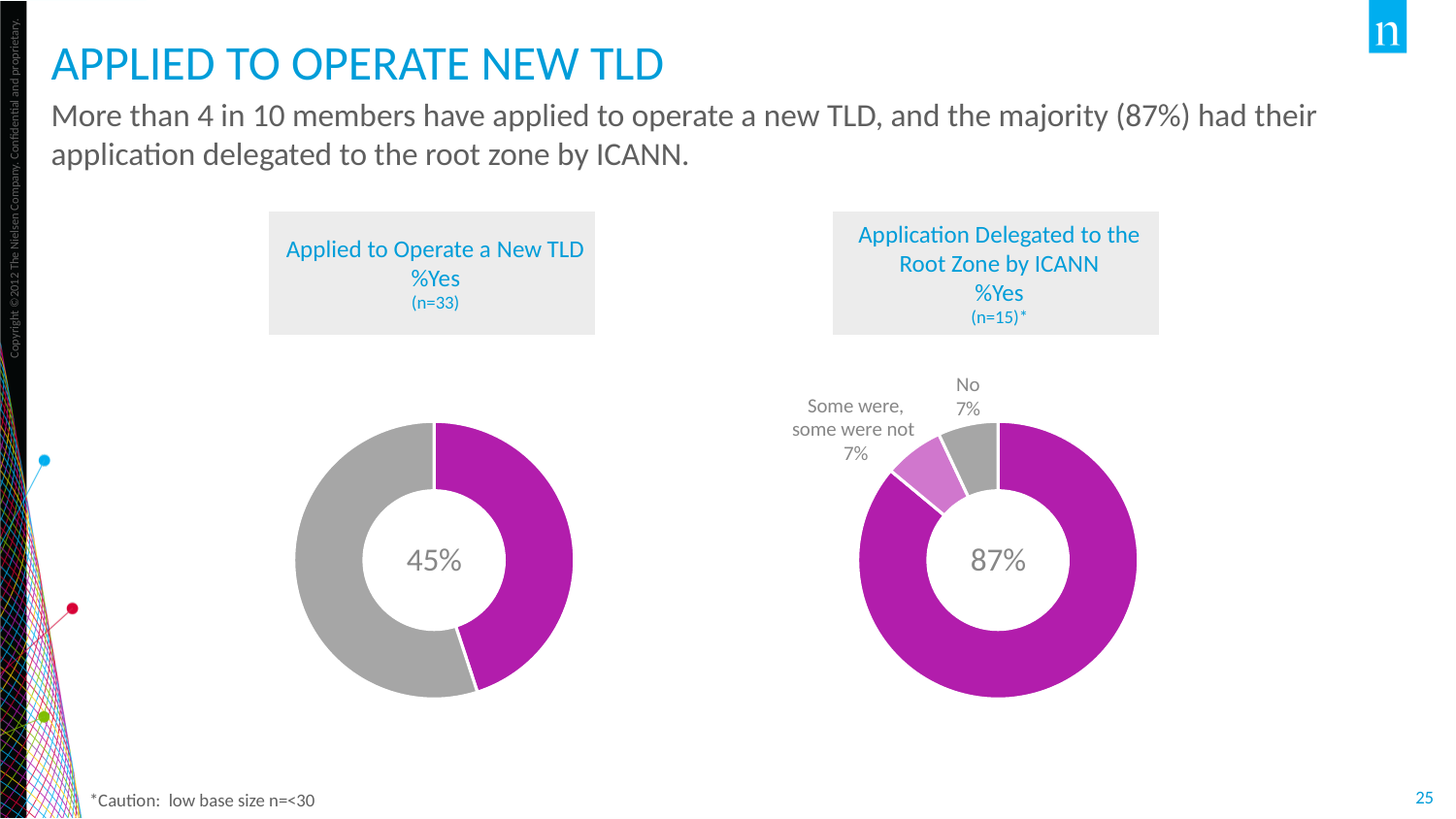
In the 'Application Delegated to the Root Zone by ICANN' chart, what percentage said Yes? 87% What kind of chart is used for 'Applied to Operate a New TLD'? Donut (pie) chart In the 'Application Delegated to the Root Zone by ICANN' chart, what percentage is labelled 'Some were, some were not'? 7% What is the sample size (n) shown for the 'Application Delegated to the Root Zone by ICANN' chart? n=15 In the 'Applied to Operate a New TLD' chart, what percentage of members said Yes? 45% In the 'Application Delegated to the Root Zone by ICANN' chart, what is the difference between the Yes share and the No share? 80 percentage points Which is larger: the Yes share in the 'Applied to Operate a New TLD' chart or the Yes share in the 'Application Delegated to the Root Zone by ICANN' chart? Application Delegated to the Root Zone by ICANN (87%) In the 'Application Delegated to the Root Zone by ICANN' chart, which slice is the largest? Yes (87%) In the 'Application Delegated to the Root Zone by ICANN' chart, what percentage is labelled 'No'? 7% In the 'Application Delegated to the Root Zone by ICANN' chart, what share of the pie does the Yes slice represent? 87% How many slices does the 'Application Delegated to the Root Zone by ICANN' chart have? 3 What is the sample size (n) shown for the 'Applied to Operate a New TLD' chart? n=33